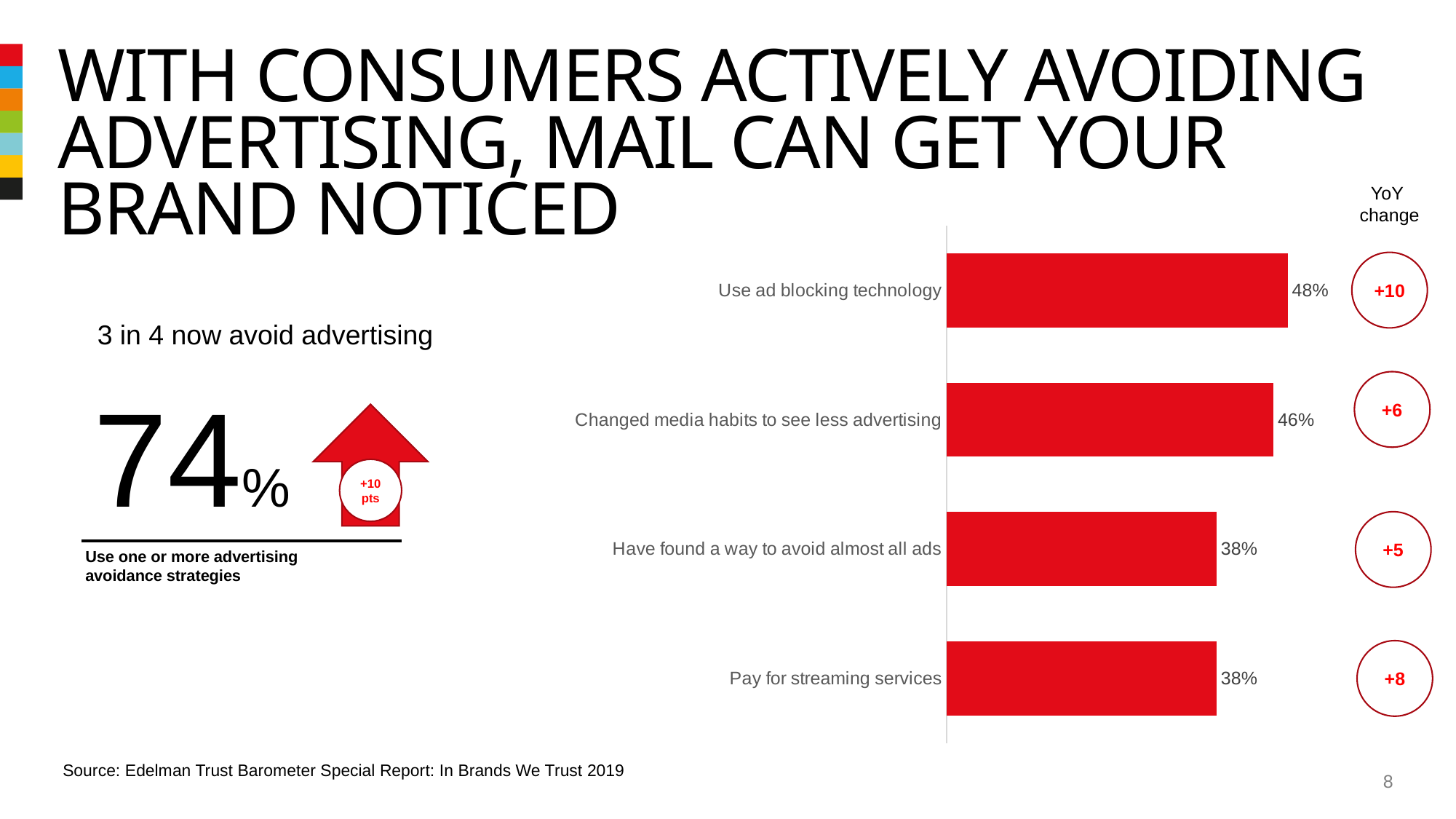
What is the value for 'Use ad blocking technology'? 48% How many categories are shown in the bar chart? 4 What is the value for 'Have found a way to avoid almost all ads'? 38% What is the value for 'Pay for streaming services'? 38% What is the value for 'Changed media habits to see less advertising'? 46% What is the YoY change shown next to 'Pay for streaming services'? +8 What kind of chart is shown on the slide? Bar chart What is the difference between 'Use ad blocking technology' and 'Changed media habits to see less advertising'? 2% Which is larger, 'Changed media habits to see less advertising' or 'Have found a way to avoid almost all ads'? Changed media habits to see less advertising Which category has the highest value? Use ad blocking technology What is the YoY change shown next to 'Use ad blocking technology'? +10 What is the difference between 'Use ad blocking technology' and 'Pay for streaming services'? 10%